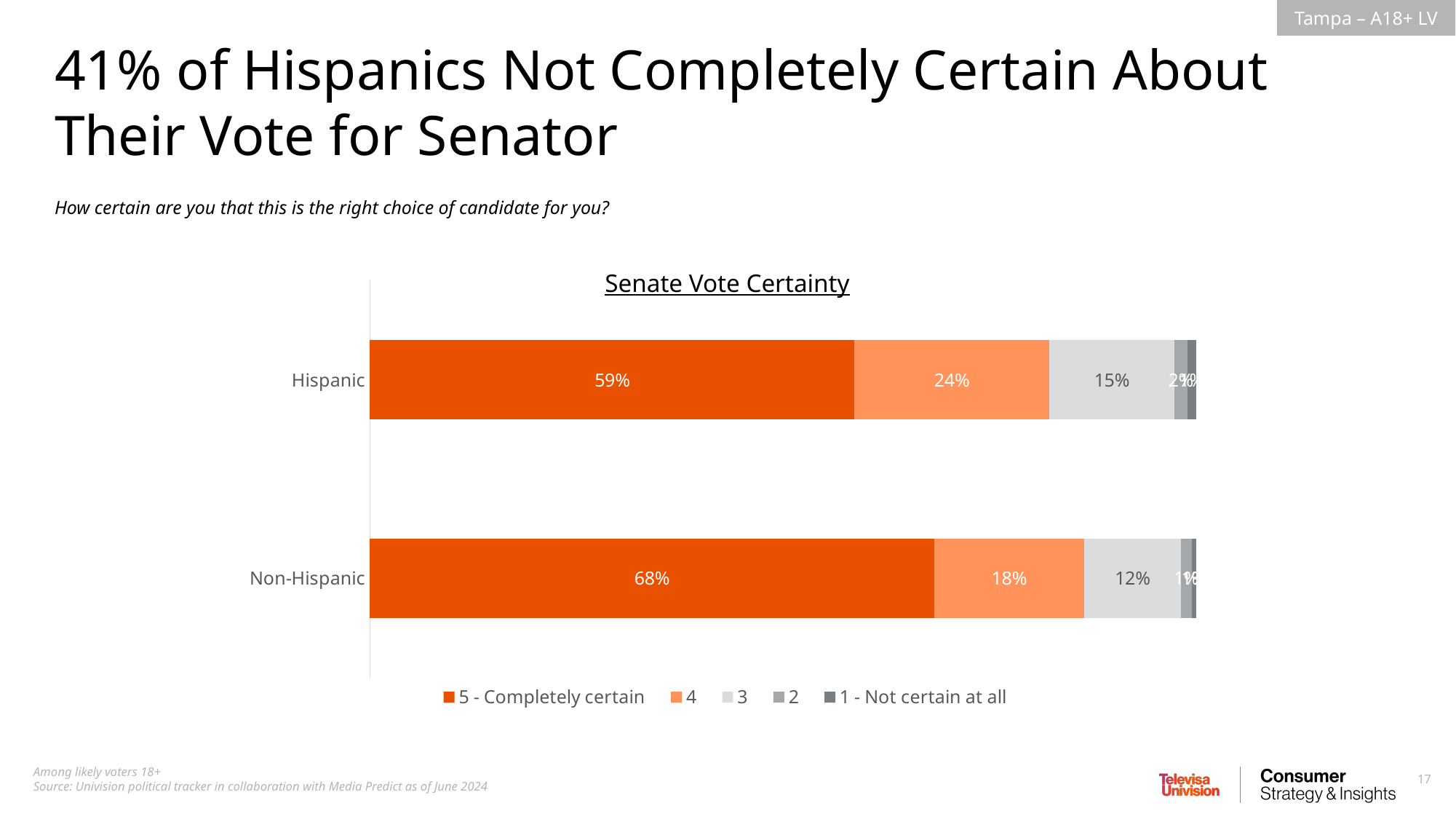
How many series does the legend list? 5 What is the value of the '4' segment for Hispanic respondents? 24% What percentage of Hispanic respondents are '5 - Completely certain'? 59% What kind of chart is shown on the slide? Stacked bar chart What is the difference in percentage points between the '5 - Completely certain' shares for Non-Hispanic and Hispanic respondents? 9 percentage points Which group has the larger share of '5 - Completely certain' respondents, Hispanic or Non-Hispanic? Non-Hispanic What is the value of the '3' segment for Non-Hispanic respondents? 12% How many categories are plotted on the chart? 2 What is the title of the chart? Senate Vote Certainty What percentage of Non-Hispanic respondents are '5 - Completely certain'? 68% What is the value of the '3' segment for Hispanic respondents? 15% Which series has the largest segment in the Hispanic bar? 5 - Completely certain